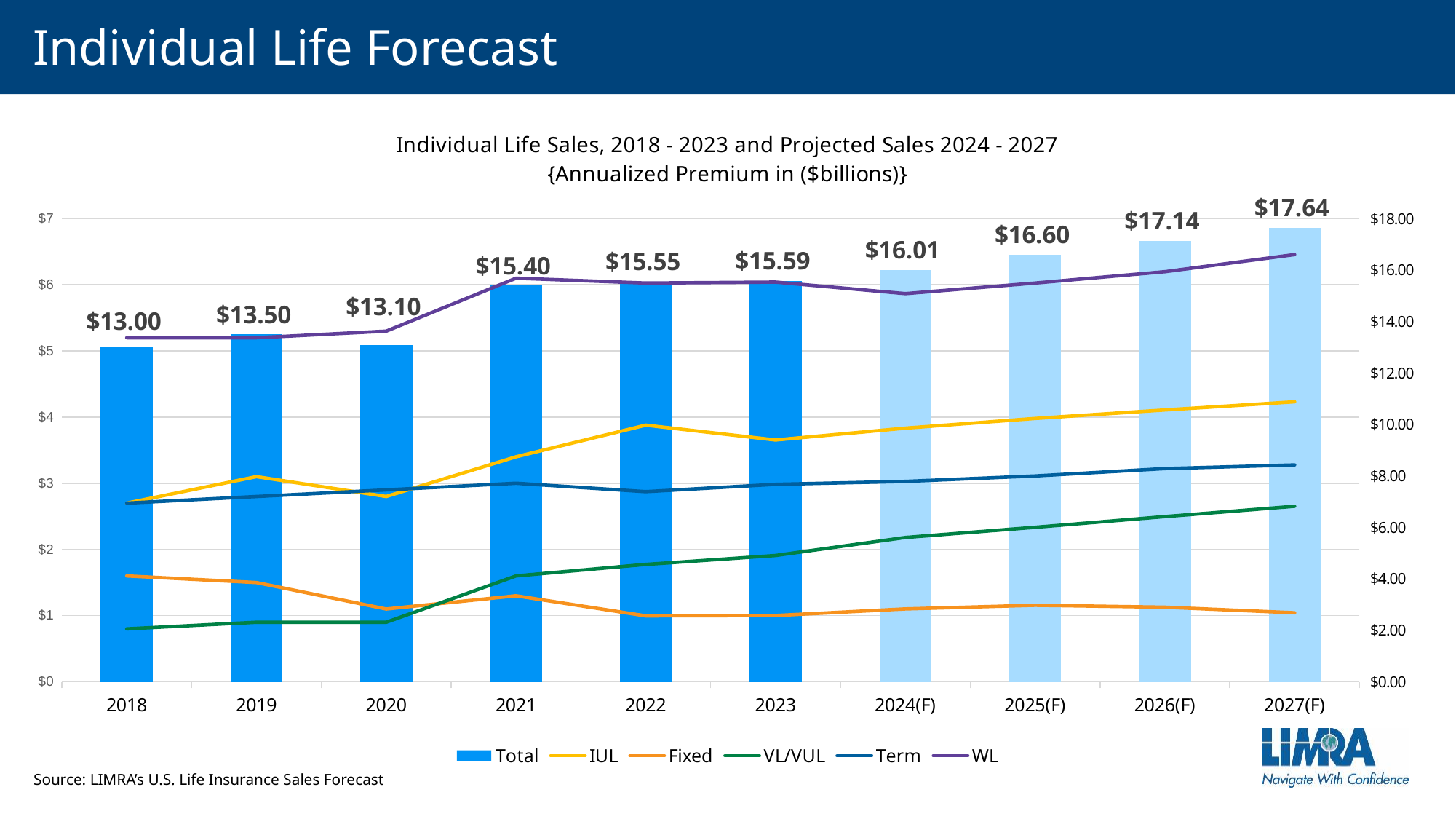
Is the WL line value for 2018 greater or less than $5 on the left axis? greater Is the Fixed line value for 2027(F) greater or less than $2 on the left axis? less What is the Total value shown for 2021? $15.40 How many years are shown on the x axis? 10 Which year has the lowest Total value? 2018 What kind of chart is this? Combined bar and line chart Which year has the highest Total value? 2027(F) What is the difference between the Total values for 2021 and 2020? $2.30 How many series does the legend list? 6 What is the Total value shown for 2027(F)? $17.64 Which is larger, the Total value for 2019 or for 2020? 2019 What is the difference between the Total values for 2027(F) and 2018? $4.64